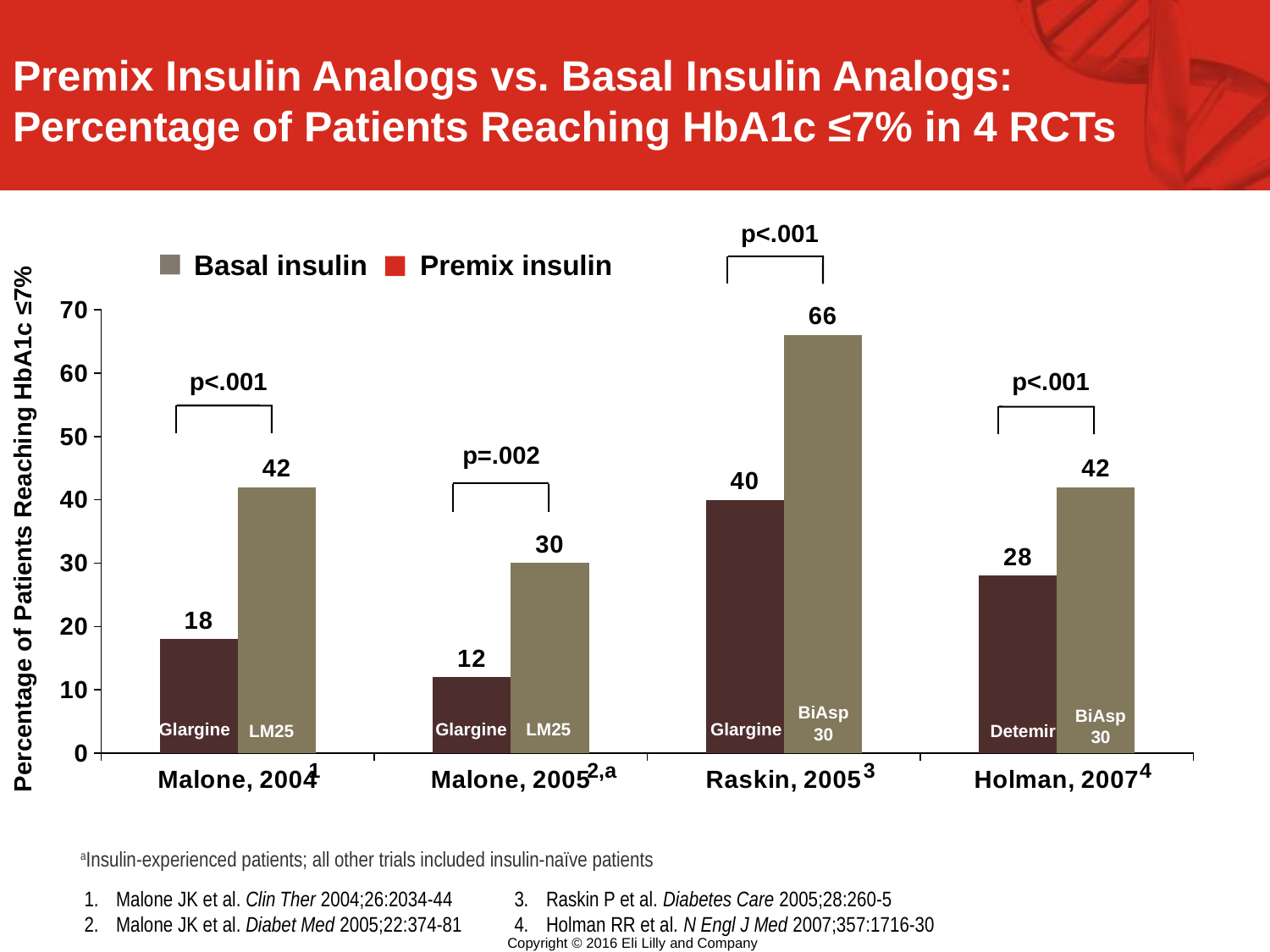
Which study shows the lowest percentage of patients reaching HbA1c ≤7% with basal insulin? Malone, 2005 What is the difference between the premix insulin and basal insulin values in Raskin, 2005? 26 How many series does the legend list? 2 What is the value for basal insulin (Glargine) in Malone, 2004? 18 What percentage of patients reached HbA1c ≤7% with premix insulin in Raskin, 2005? 66 What is the difference between the premix insulin and basal insulin values in Malone, 2004? 24 Which study shows the highest percentage of patients reaching HbA1c ≤7% with premix insulin? Raskin, 2005 How many studies (categories) are shown on the x axis? 4 What is the value for premix insulin (LM25) in Malone, 2005? 30 What kind of chart is shown on the slide? Bar chart What is the value for basal insulin (Detemir) in Holman, 2007? 28 Which is larger: the basal insulin value in Raskin, 2005 or the basal insulin value in Holman, 2007? Raskin, 2005